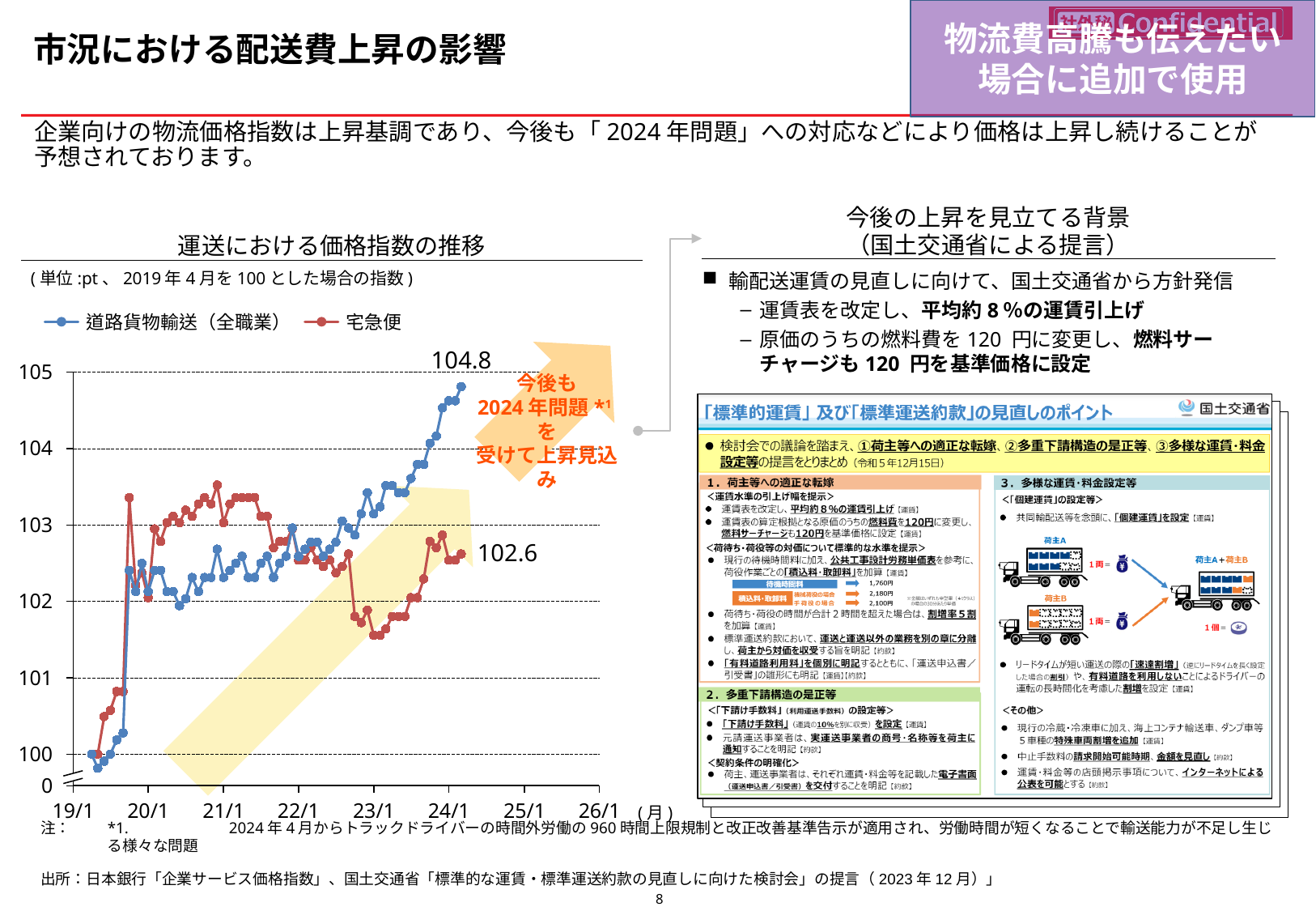
According to the note under the chart title, which month is set to 100 for the index? 2019年4月 In the 運送における価格指数の推移 chart, is the latest value for 道路貨物輸送（全職業） greater or less than 104? greater In the 運送における価格指数の推移 chart, what is the difference between the latest labelled values of 道路貨物輸送（全職業） and 宅急便? 2.2 In the 運送における価格指数の推移 chart, what is the latest labelled value for 道路貨物輸送（全職業）? 104.8 How many series does the legend of the 運送における価格指数の推移 chart list? 2 In the 運送における価格指数の推移 chart, does the 道路貨物輸送（全職業） series generally rise or fall from 19/1 to 24/1? rise In the 運送における価格指数の推移 chart, what is the latest labelled value for 宅急便? 102.6 What type of chart is used in 運送における価格指数の推移? line chart In the 運送における価格指数の推移 chart, what is the highest labelled value shown for 道路貨物輸送（全職業）? 104.8 What is the title of the line chart on the left of the slide? 運送における価格指数の推移 In the 運送における価格指数の推移 chart, which series has the higher latest labelled value, 道路貨物輸送（全職業） or 宅急便? 道路貨物輸送（全職業） In the 運送における価格指数の推移 chart, is the latest value for 宅急便 greater or less than 103? less